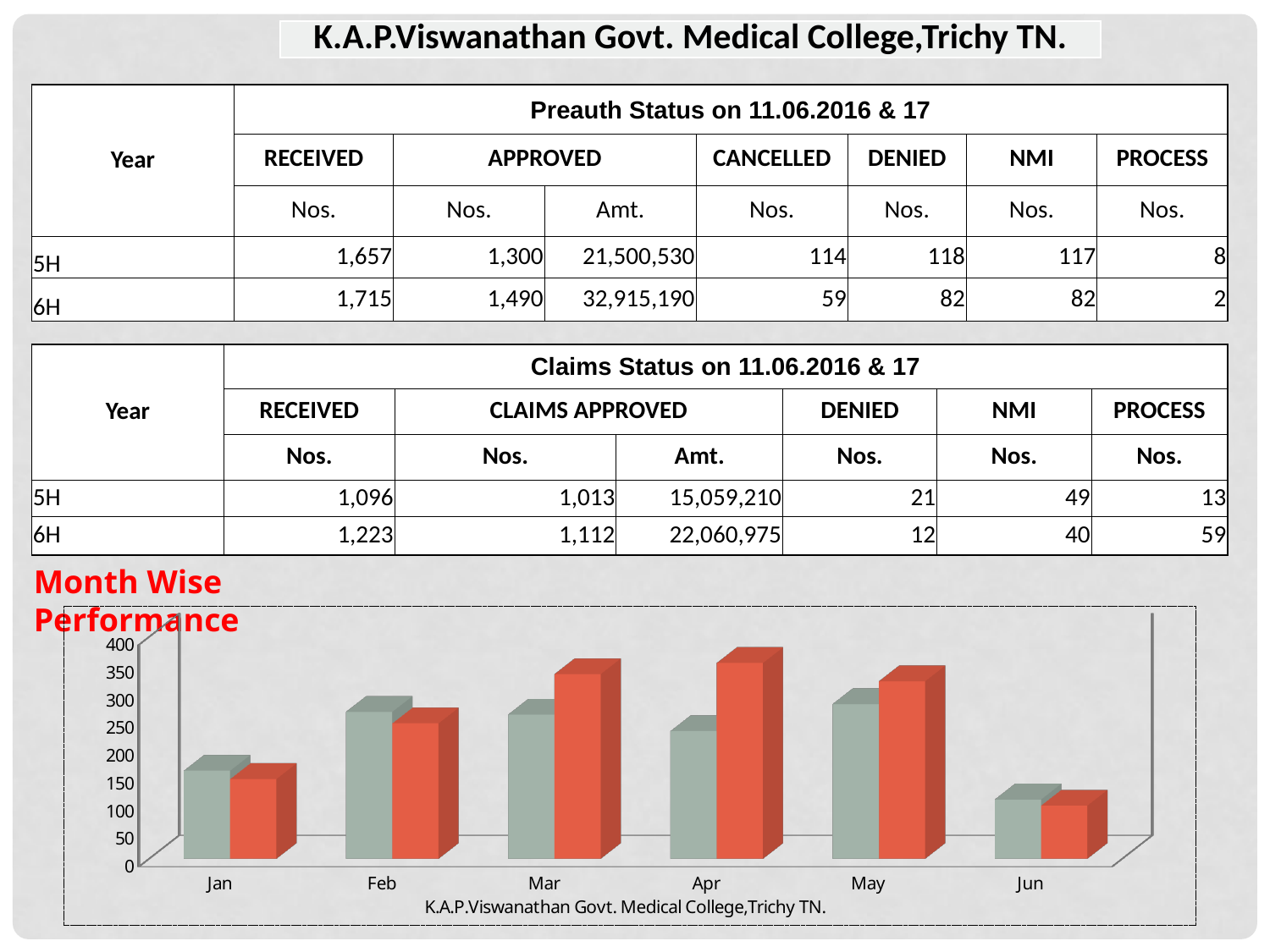
In the bar chart, which month has the tallest red bar? Apr In the bar chart, which month has the shortest grey bar? Jun In the bar chart, for Apr, which is taller: the grey bar or the red bar? the red bar In the bar chart, is the red bar for Mar greater or less than 300? greater What kind of chart is shown under the heading 'Month Wise Performance'? bar chart In the bar chart, do the red bars rise or fall from Apr to Jun? fall How many bars are plotted for each month in the bar chart? 2 How many months are shown on the x axis of the bar chart? 6 In the bar chart, is the red bar for Jun greater or less than 150? less In the bar chart, is the grey bar for Jan greater or less than 200? less In the bar chart, which month has the shortest red bar? Jun